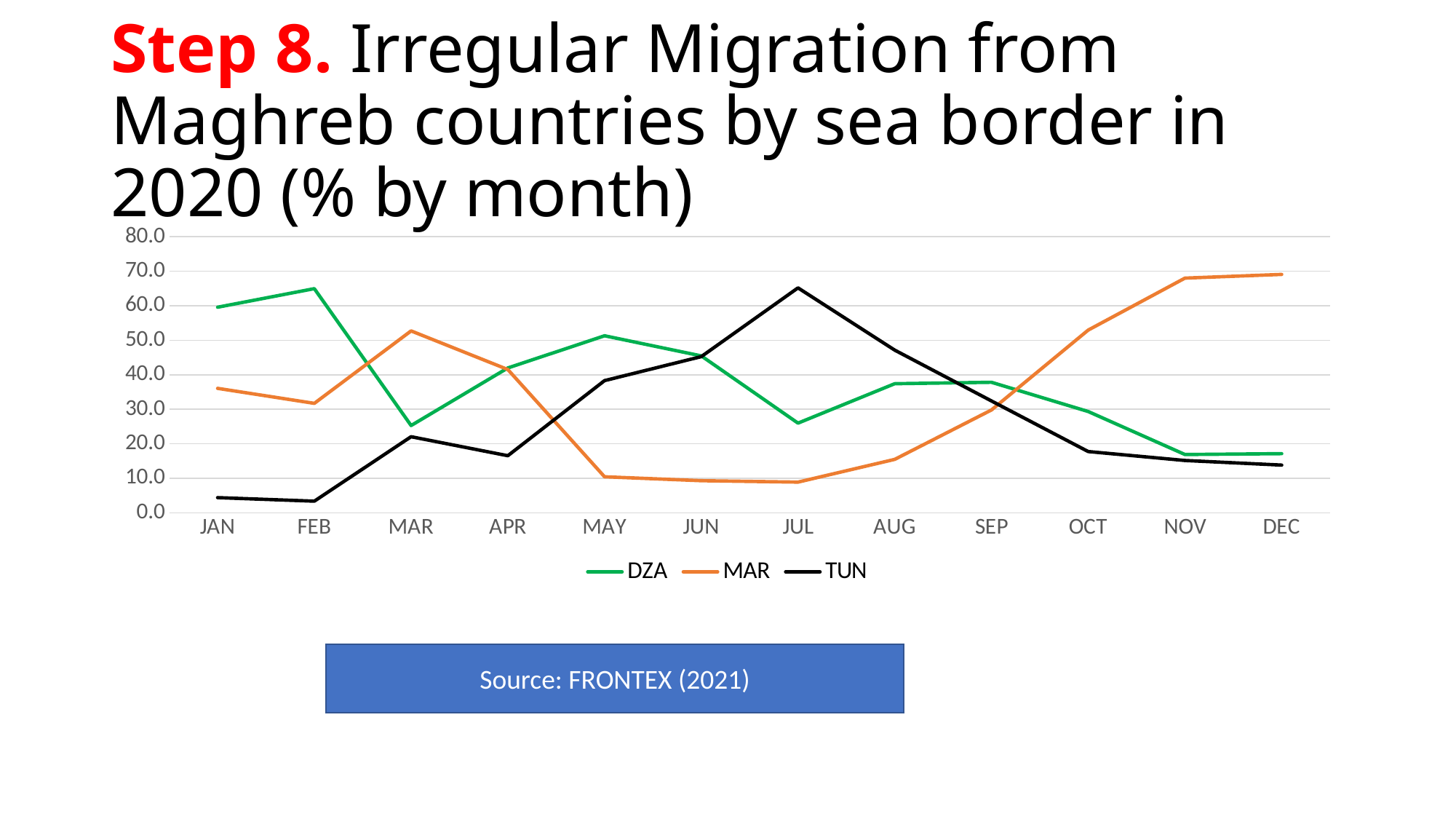
How many months are shown along the x axis? 12 In which month does the DZA series reach its highest value? FEB Is the value for DZA in MAR greater or less than 30.0? less What kind of chart is shown on the slide? line chart Which colour is used for the TUN series? black Does the MAR series rise or fall from AUG to DEC? rise Is the value for TUN in JUL greater or less than 60.0? greater How many series does the legend list? 3 Is the value for MAR in MAY greater or less than 20.0? less In JAN, which series has the larger value, DZA or MAR? DZA In which month does the TUN series reach its highest value? JUL